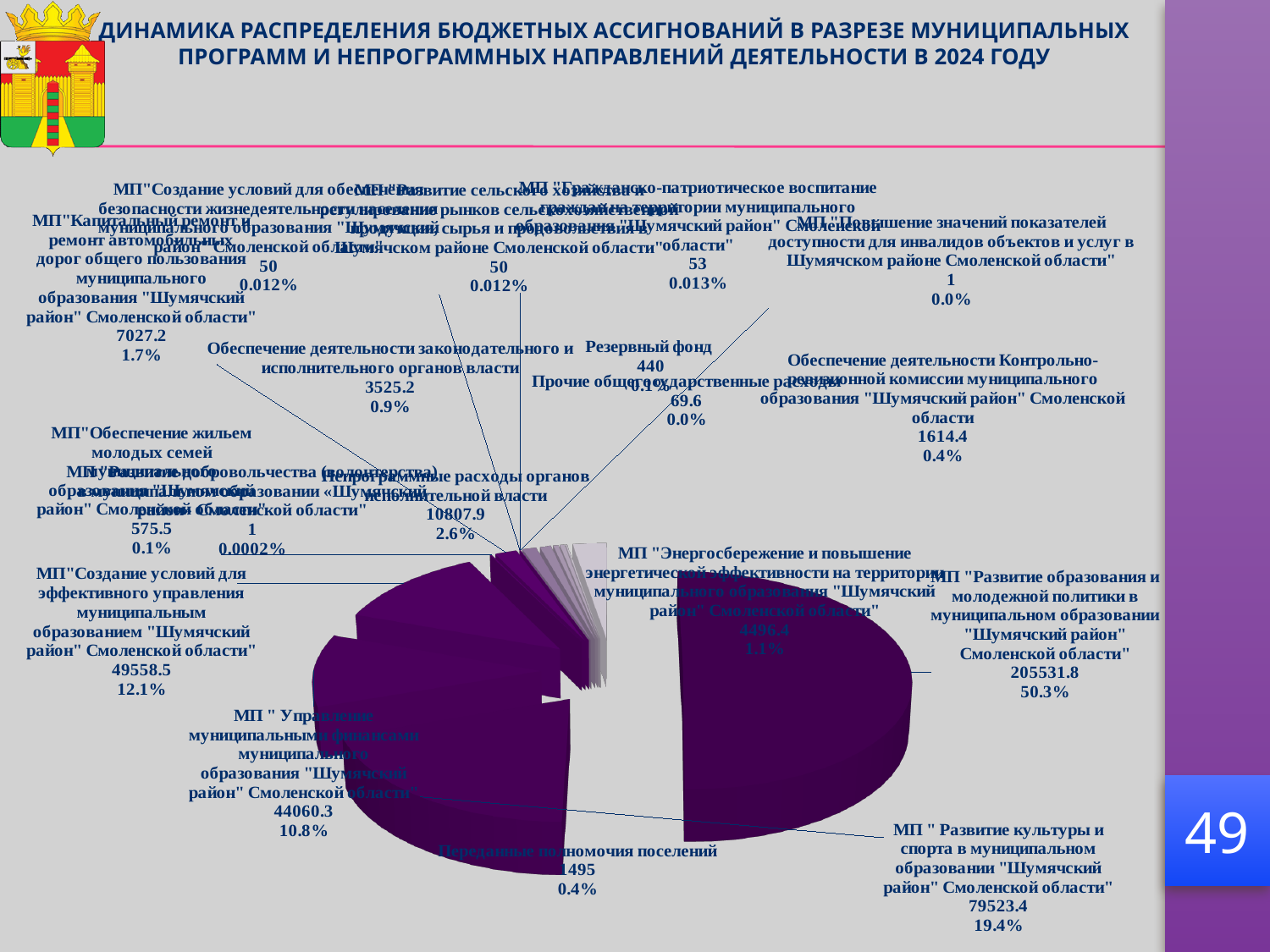
What is the value shown for Непрограммные расходы органов исполнительной власти? 10807.9 What share of the pie does МП "Энергосбережение и повышение энергетической эффективности..." have? 1.1% What kind of chart is shown on the slide? Pie chart What share of the pie does МП "Создание условий для эффективного управления муниципальным образованием "Шумячский район" Смоленской области" have? 12.1% What is the difference between the values for МП "Развитие культуры и спорта..." (79523.4) and МП "Создание условий для эффективного управления..." (49558.5)? 29964.9 What is the value shown for МП "Капитальный ремонт и ремонт автомобильных дорог общего пользования..."? 7027.2 What is the value shown for МП "Развитие образования и молодежной политики в муниципальном образовании "Шумячский район" Смоленской области"? 205531.8 What is the value shown for Резервный фонд? 440 What share of the pie does МП "Развитие культуры и спорта в муниципальном образовании "Шумячский район" Смоленской области" have? 19.4% Which is larger: the value for Обеспечение деятельности Контрольно-ревизионной комиссии (1614.4) or Переданные полномочия поселений (1495)? Обеспечение деятельности Контрольно-ревизионной комиссии What is the value shown for МП "Управление муниципальными финансами муниципального образования "Шумячский район" Смоленской области"? 44060.3 Which category has the largest slice of the pie? МП "Развитие образования и молодежной политики в муниципальном образовании "Шумячский район" Смоленской области"